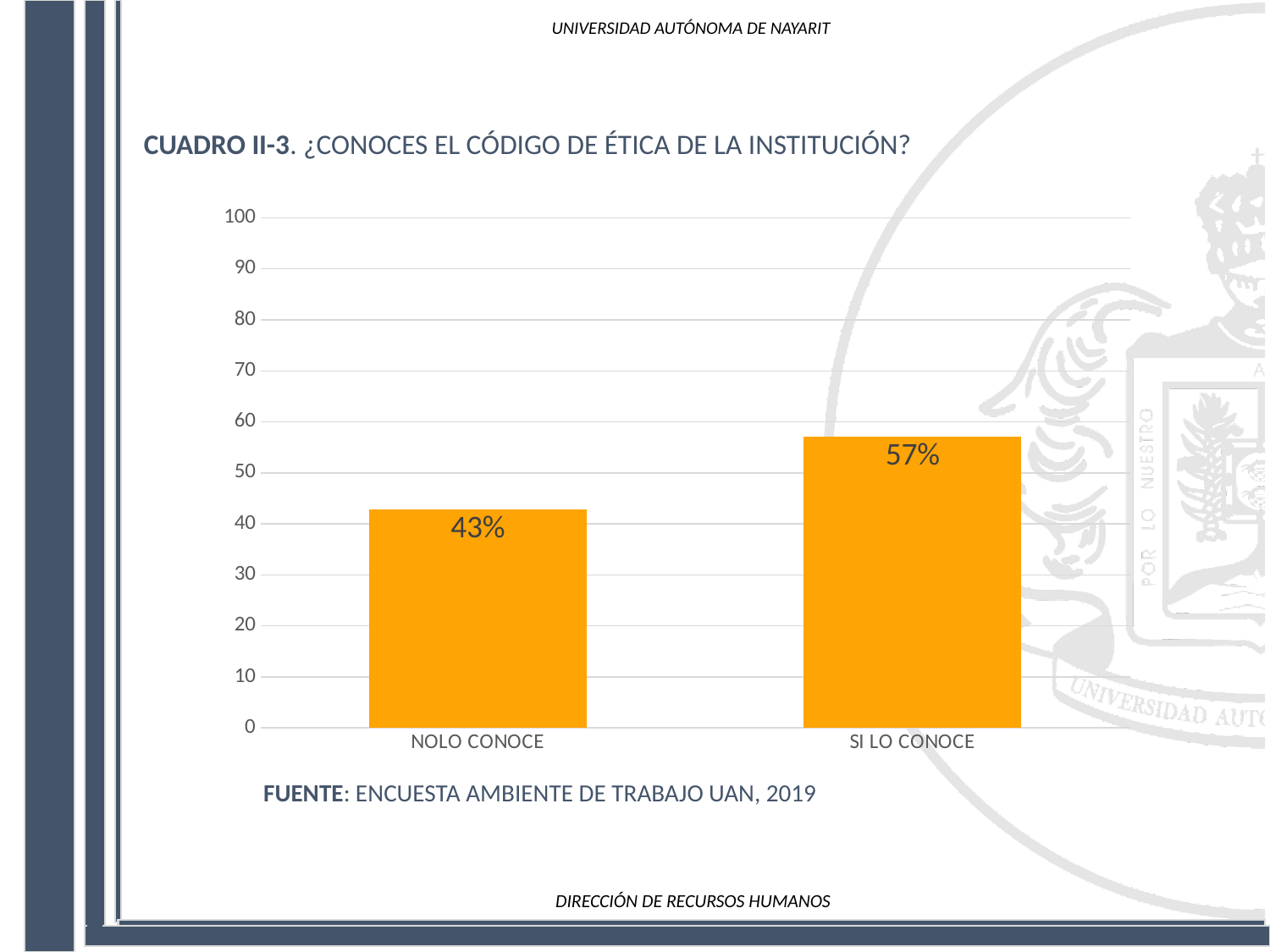
Which is larger, the value for NOLO CONOCE or the value for SI LO CONOCE? SI LO CONOCE What is the value for NOLO CONOCE? 43% What is the difference between the values for SI LO CONOCE and NOLO CONOCE? 14% What is the title of the chart? CUADRO II-3. ¿CONOCES EL CÓDIGO DE ÉTICA DE LA INSTITUCIÓN? Is the value for SI LO CONOCE greater or less than 50? greater What is the source cited below the chart? ENCUESTA AMBIENTE DE TRABAJO UAN, 2019 Is the value for NOLO CONOCE greater or less than 50? less What is the value for SI LO CONOCE? 57% What kind of chart is shown on the slide? bar chart Which category has the lowest value? NOLO CONOCE Which category has the highest value? SI LO CONOCE How many categories are shown on the x axis? 2